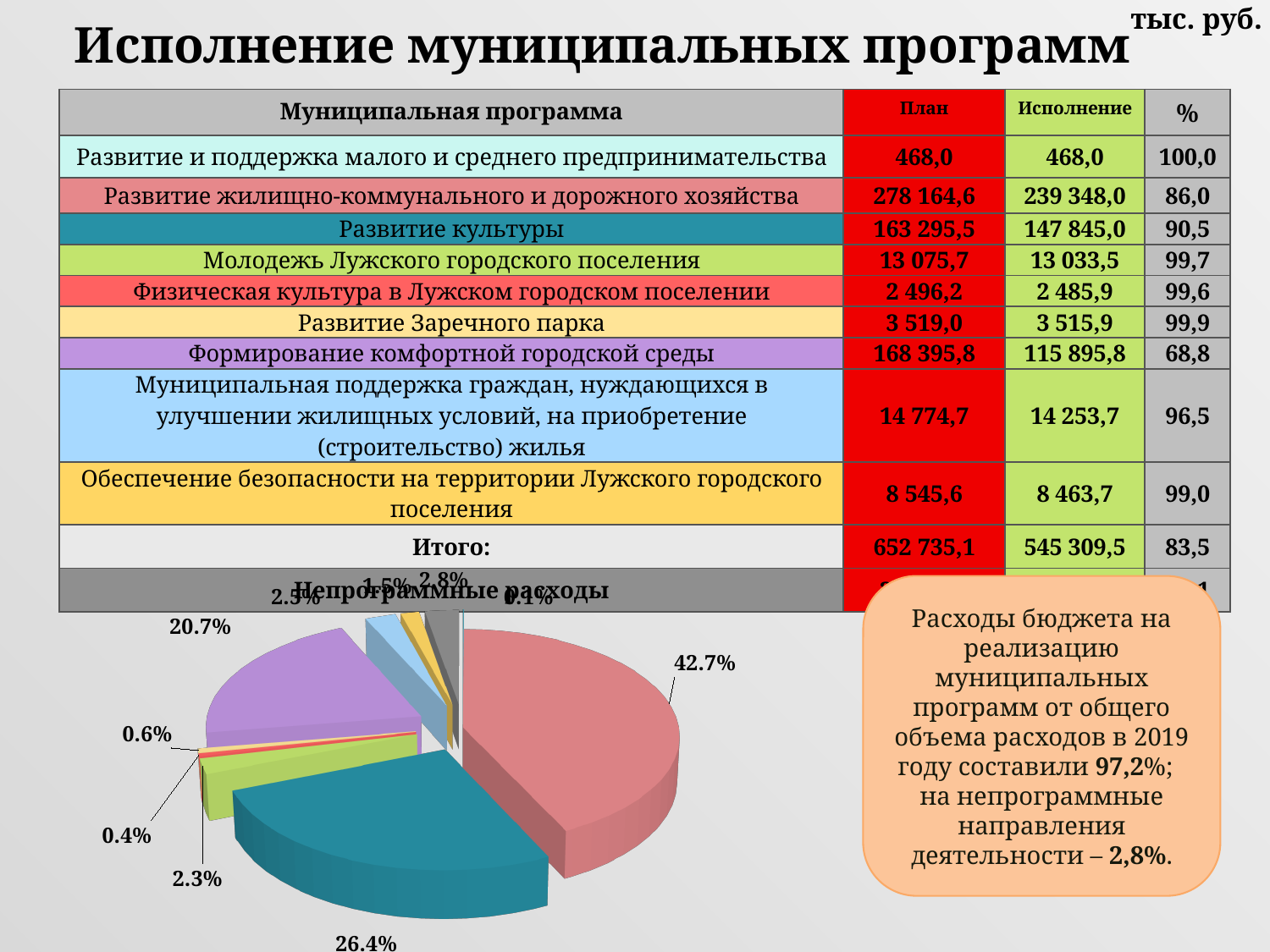
What kind of chart is shown at the bottom left of the slide? Pie chart In the pie chart, what share is shown for the pink slice? 42.7% Is the pie chart drawn in 3D? Yes In the pie chart, which slice is larger: the pink slice or the teal slice? The pink slice In the pie chart, what is the share of the largest slice? 42.7% In the pie chart, what is the difference in percentage points between the largest slice (42.7%) and the second largest slice (26.4%)? 16.3 percentage points In the pie chart, what is the share of the smallest labelled slice? 0.1% In the pie chart, what share is shown for the teal (dark blue-green) slice? 26.4% In the pie chart, what is the difference in percentage points between the purple slice (20.7%) and the green slice (2.3%)? 18.4 percentage points Does the pie chart have a legend? No In the pie chart, what share is shown for the purple slice? 20.7%